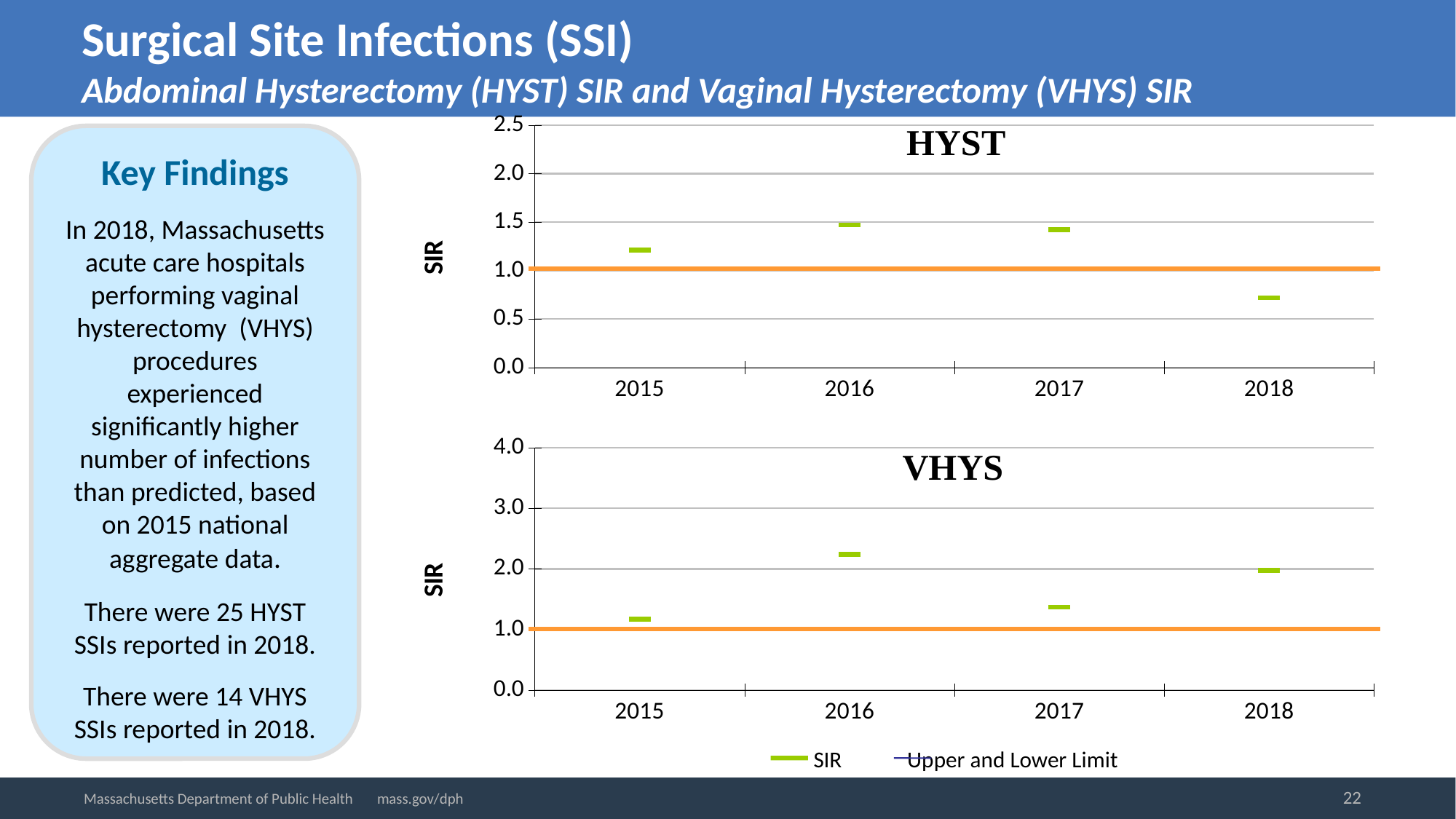
On the VHYS chart, which is larger, the SIR for 2016 or the SIR for 2017? 2016 How many years are plotted on the HYST chart? 4 On the VHYS chart, at what value does the orange Upper and Lower Limit line sit? 1.0 On the HYST chart, is the SIR value for 2016 greater or less than 1.0? greater How many series does the legend below the VHYS chart list? 2 On the HYST chart, which is larger, the SIR for 2015 or the SIR for 2018? 2015 On the VHYS chart, is the SIR value for 2017 greater or less than 2.0? less On the HYST chart, which year has the lowest SIR? 2018 On the HYST chart, is the SIR value for 2018 greater or less than 1.0? less On the VHYS chart, which year has the highest SIR? 2016 On the VHYS chart, which year has the lowest SIR? 2015